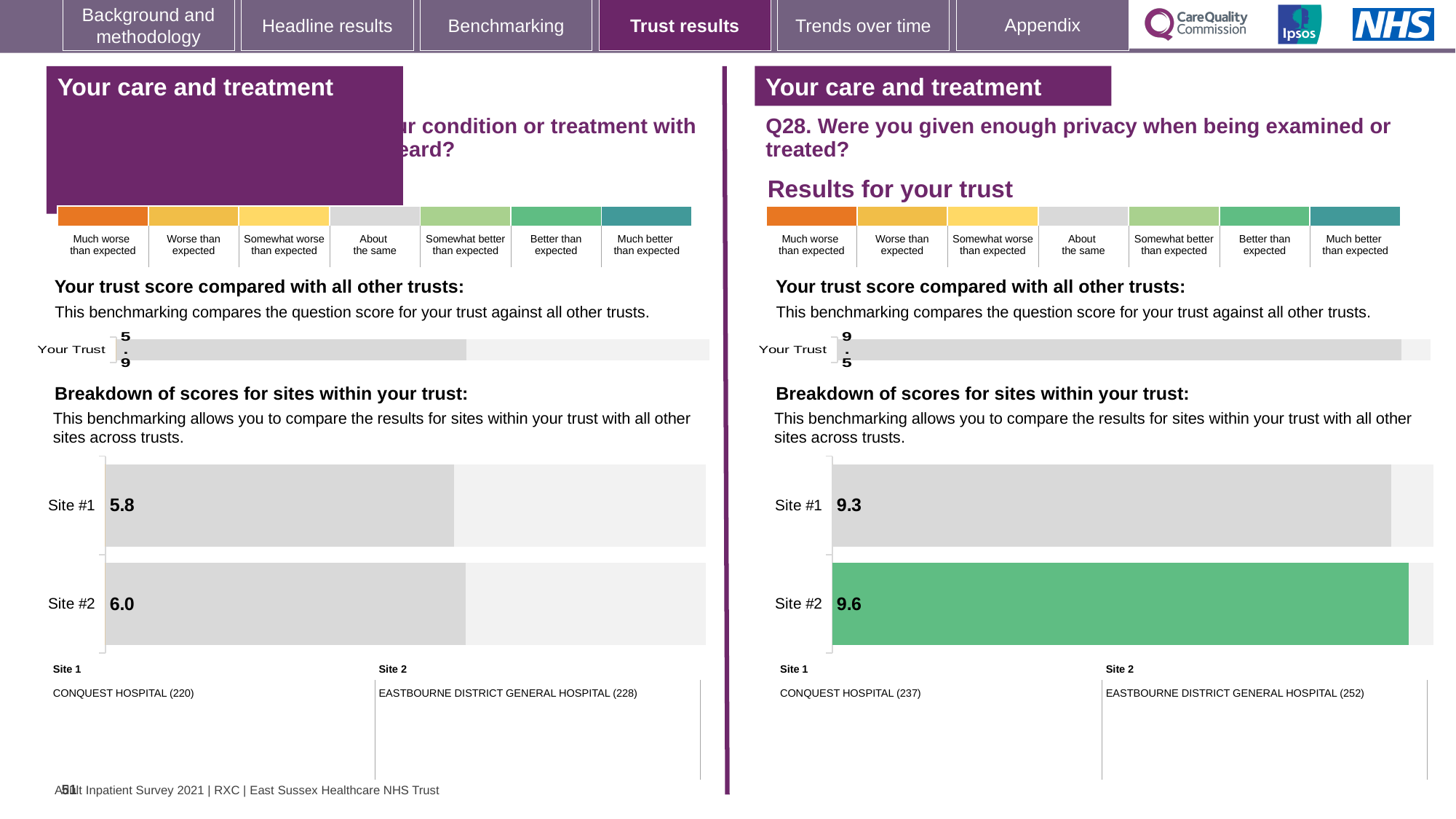
On the left-hand slide, what is the score for Site #2 in the breakdown of scores for sites within your trust? 6.0 How many sites are shown in the site breakdown chart on the right-hand slide (Q28)? 2 What type of chart is used for the breakdown of scores for sites on the right-hand slide (Q28)? Bar chart On the left-hand slide, what is the difference between the Site #2 and Site #1 scores? 0.2 On the right-hand slide (Q28), what is the score for Site #1 in the breakdown of scores for sites within your trust? 9.3 On the left-hand slide, what is the score shown for Your Trust in the trust score chart? 5.9 On the right-hand slide (Q28), what is the score for Site #2 in the breakdown of scores for sites within your trust? 9.6 On the right-hand slide (Q28), what is the score shown for Your Trust in the trust score chart? 9.5 On the right-hand slide (Q28), what is the difference between the Site #2 and Site #1 scores? 0.3 On the left-hand slide, what is the score for Site #1 in the breakdown of scores for sites within your trust? 5.8 On the left-hand slide, which site has the lower score in the site breakdown chart? Site #1 On the right-hand slide (Q28), which site has the higher score in the site breakdown chart? Site #2